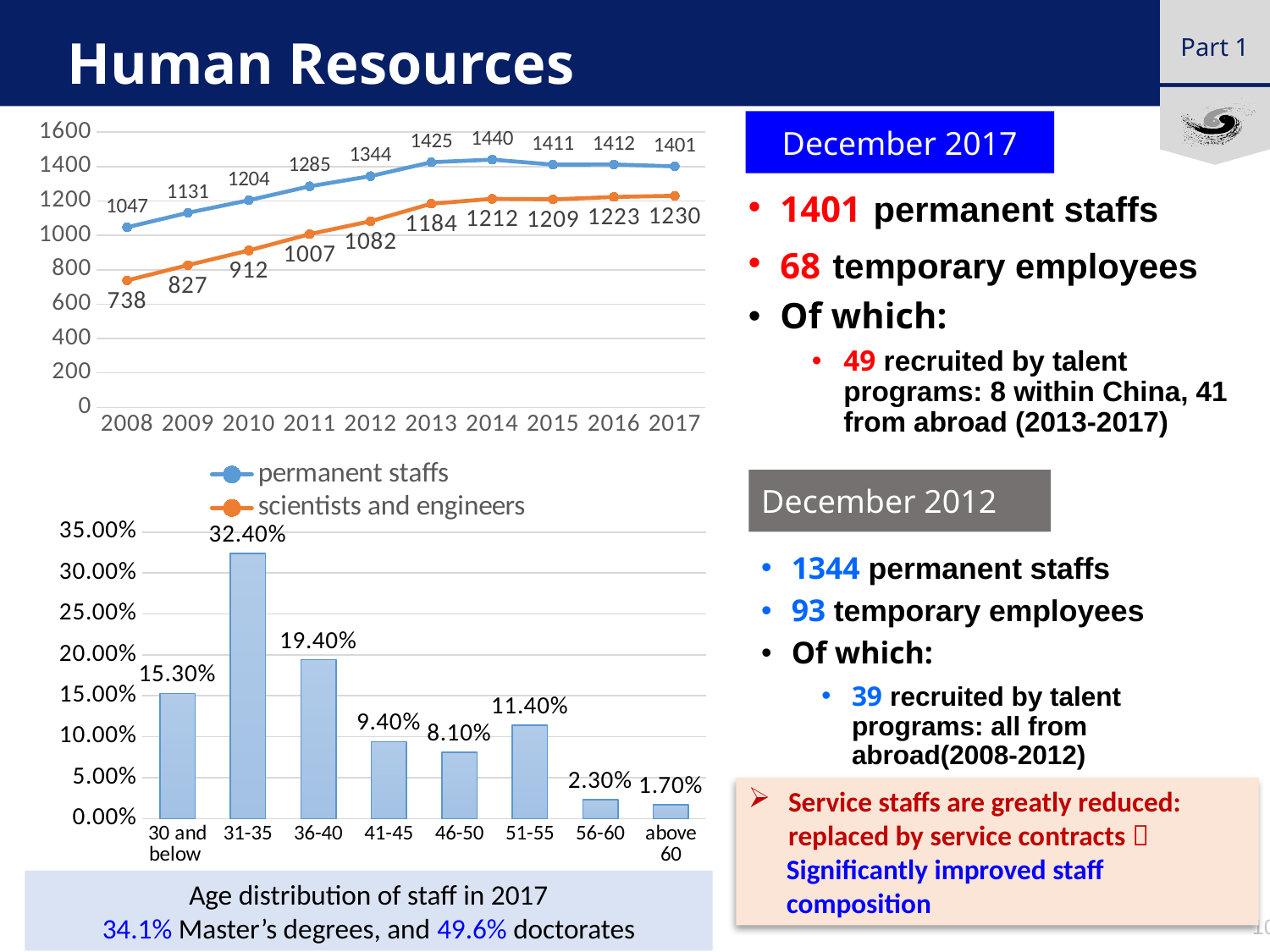
In the top line chart, which year has the highest value for permanent staffs? 2014 In the top line chart, do the values for scientists and engineers rise or fall from 2008 to 2013? rise In the bottom bar chart (age distribution of staff in 2017), which age group has the lowest share? above 60 In the top line chart, what is the value for permanent staffs in 2014? 1440 In the top line chart, how many series does the legend list? 2 In the bottom bar chart (age distribution of staff in 2017), which age group has the highest share? 31-35 In the top line chart, what is the difference between permanent staffs and scientists and engineers in 2017? 171 In the top line chart, what is the value for scientists and engineers in 2008? 738 What kind of chart is the bottom chart showing the age distribution of staff in 2017? bar chart In the top line chart, how many years are shown on the x axis? 10 In the bottom bar chart (age distribution of staff in 2017), which is larger, the value for 41-45 or the value for 51-55? 51-55 In the bottom bar chart (age distribution of staff in 2017), what is the value for the 36-40 age group? 19.40%